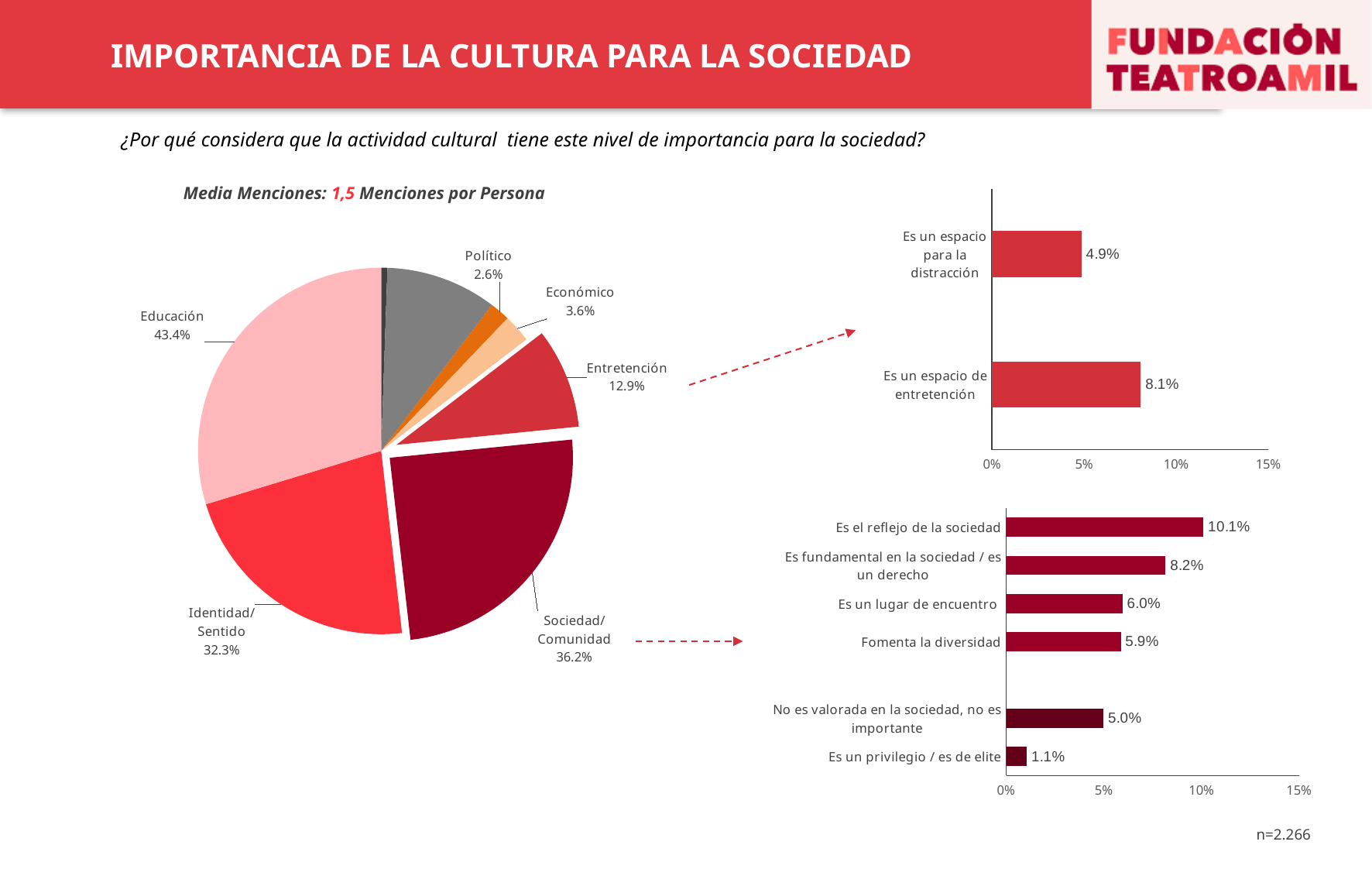
In the pie chart on the left, what is the difference between the percentages for Económico and Político? 1.0% In the pie chart on the left, which labelled category has the largest percentage? Educación In the top-right bar chart, what is the value for 'Es un espacio de entretención'? 8.1% In the bottom-right bar chart, what is the value for 'Es el reflejo de la sociedad'? 10.1% In the pie chart on the left, what percentage is shown for Educación? 43.4% In the bottom-right bar chart, which category has the lowest value? Es un privilegio / es de elite In the pie chart on the left, which is larger: Sociedad/Comunidad or Entretención? Sociedad/Comunidad In the pie chart on the left, which labelled category has the smallest percentage? Político In the pie chart on the left, what percentage is shown for Identidad/Sentido? 32.3% How many categories does the top-right bar chart show? 2 What type of chart is the chart on the left of the slide? Pie chart How many categories does the bottom-right bar chart show? 6